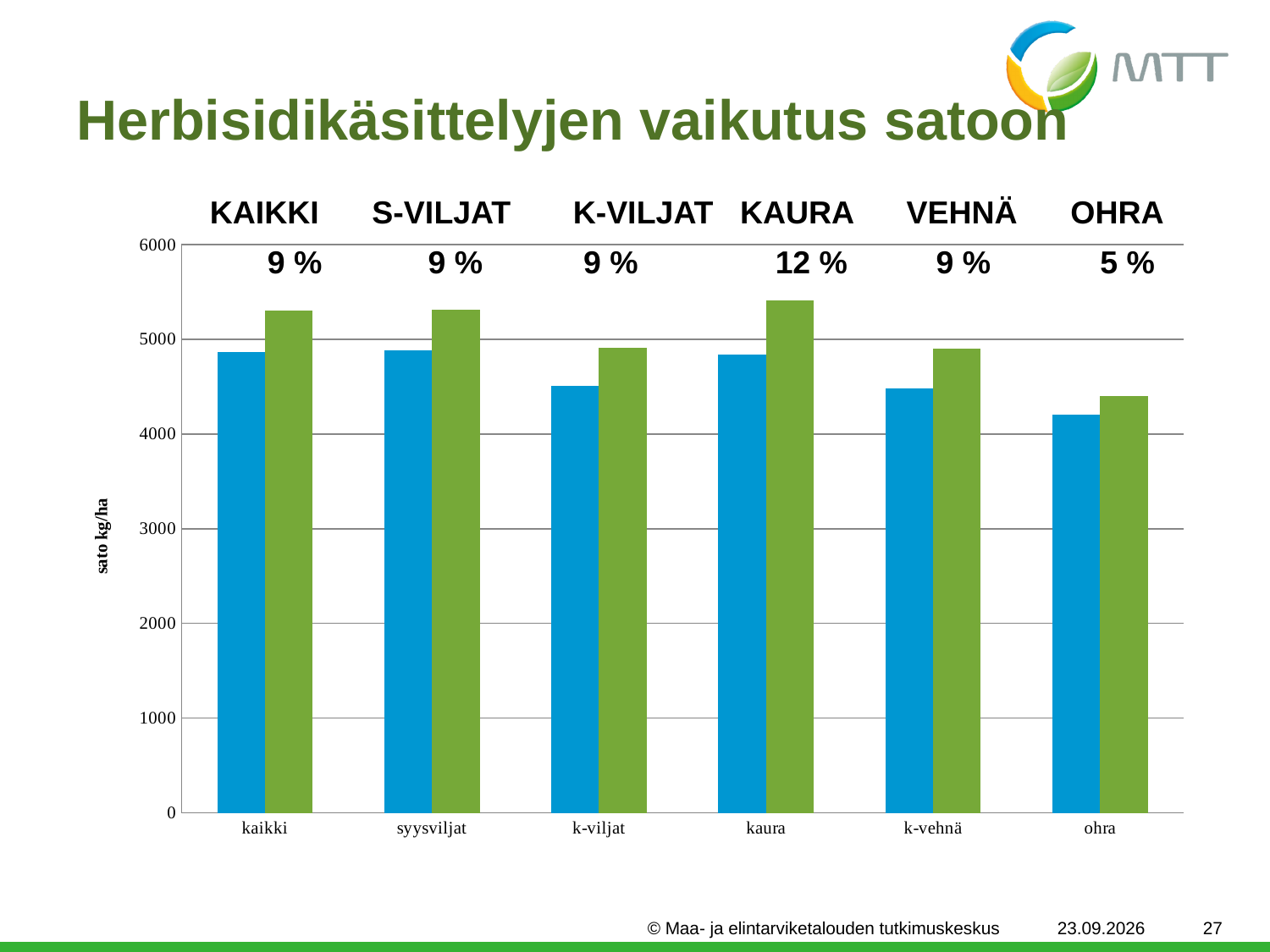
What is the label of the vertical axis of the chart? sato kg/ha Is the value of the blue bar for ohra greater or less than 5000? less What percentage is printed above the OHRA bars? 5 % Is the value of the green bar for ohra greater or less than 4000? greater What percentage is printed above the KAURA bars? 12 % Is the value of the green bar for kaura greater or less than 5000? greater How many categories are shown on the x axis of the chart? 6 Which category has the tallest green bar? kaura What kind of chart is shown on the slide? bar chart For kaura, which bar is taller, the blue bar or the green bar? the green bar Which category has the shortest blue bar? ohra